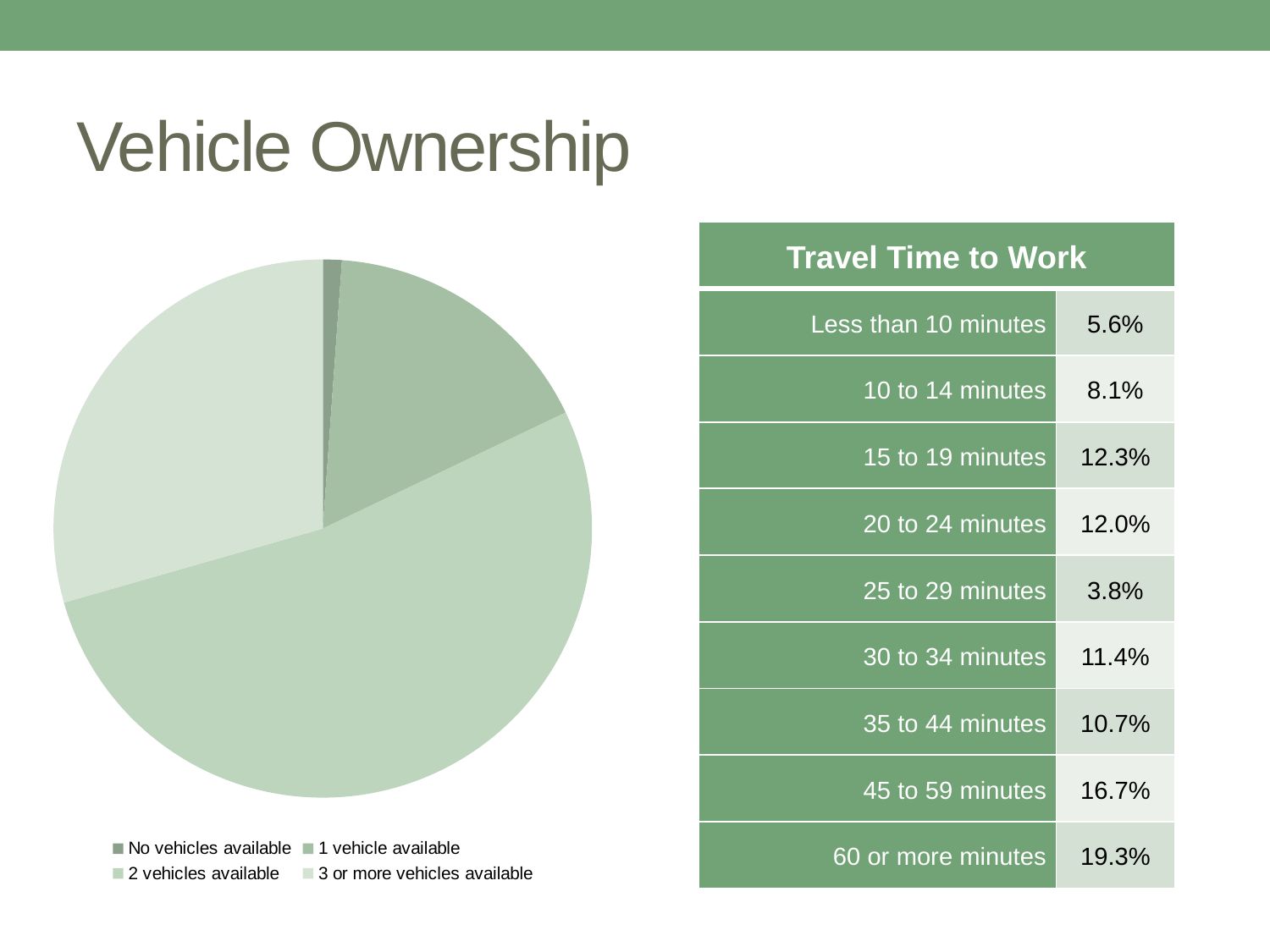
In the pie chart, which slice is larger: 1 vehicle available or 3 or more vehicles available? 3 or more vehicles available In the pie chart, which slice is larger: 2 vehicles available or 1 vehicle available? 2 vehicles available What kind of chart is shown on the left of the slide? pie chart What is the first entry listed in the pie chart's legend? No vehicles available In the pie chart, which slice is larger: No vehicles available or 1 vehicle available? 1 vehicle available Which category has the largest slice in the pie chart? 2 vehicles available Which category has the smallest slice in the pie chart? No vehicles available What is the title of the slide containing the pie chart? Vehicle Ownership How many categories does the pie chart's legend list? 4